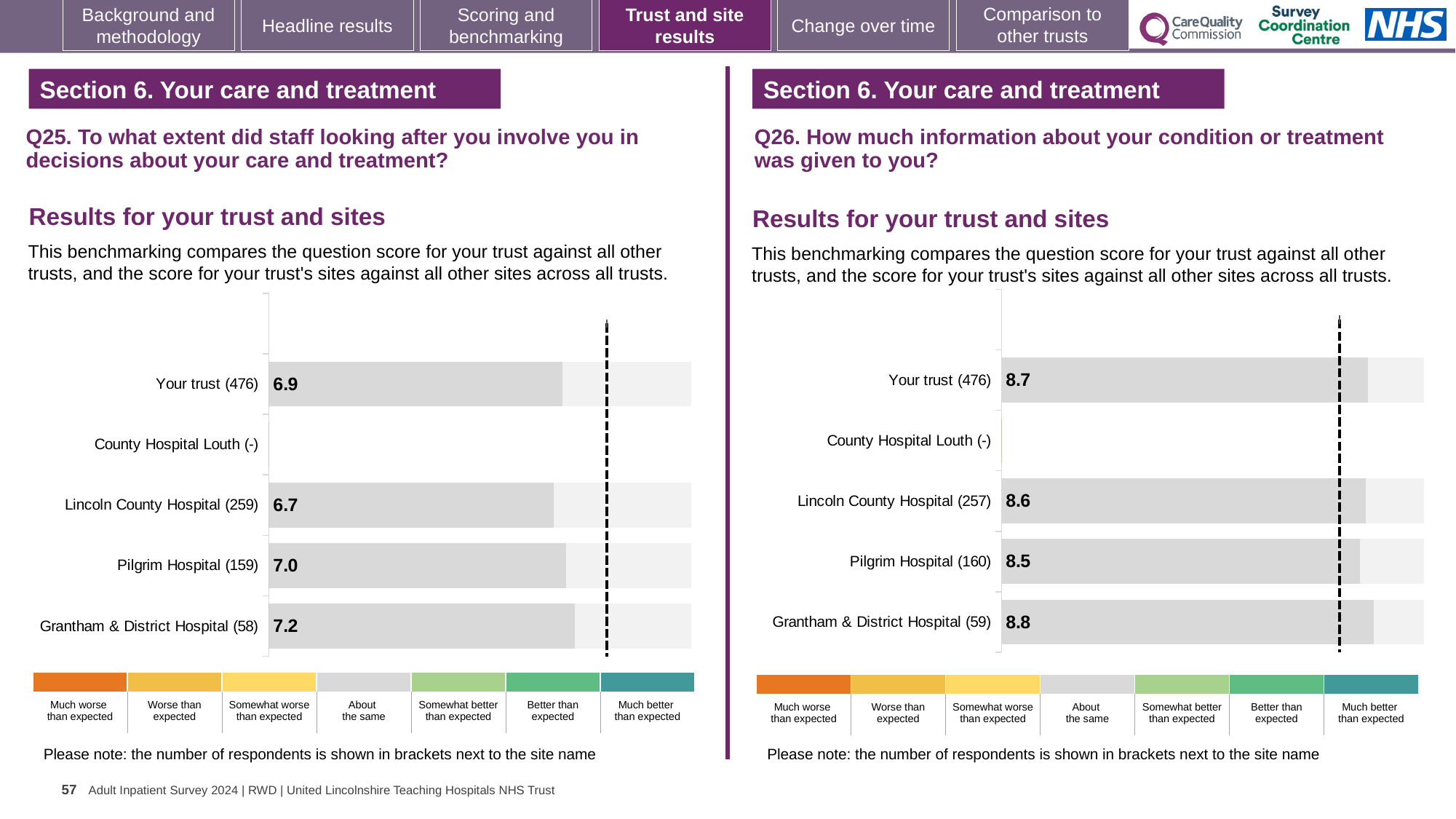
In the Q26 chart on the right, what is the score for Your trust (476)? 8.7 In the Q26 chart on the right, which is larger, the score for Pilgrim Hospital (160) or Grantham & District Hospital (59)? Grantham & District Hospital (59) In the Q25 chart on the left, what is the score for Your trust (476)? 6.9 In the Q25 chart on the left, what is the difference between the scores for Grantham & District Hospital (58) and Lincoln County Hospital (259)? 0.5 In the Q26 chart on the right, what is the difference between the scores for Your trust (476) and Pilgrim Hospital (160)? 0.2 In the Q25 chart on the left, which site has the highest score? Grantham & District Hospital (58) How many rows (trust and sites) are listed in the Q25 chart on the left? 5 In the Q25 chart on the left, what is the score for Pilgrim Hospital (159)? 7.0 In the Q26 chart on the right, what is the score for Lincoln County Hospital (257)? 8.6 In the Q26 chart on the right, which site has the highest score? Grantham & District Hospital (59) In the Q25 chart on the left, which site with a score shown has the lowest score? Lincoln County Hospital (259) What kind of chart is used in the Q26 chart on the right? Bar chart